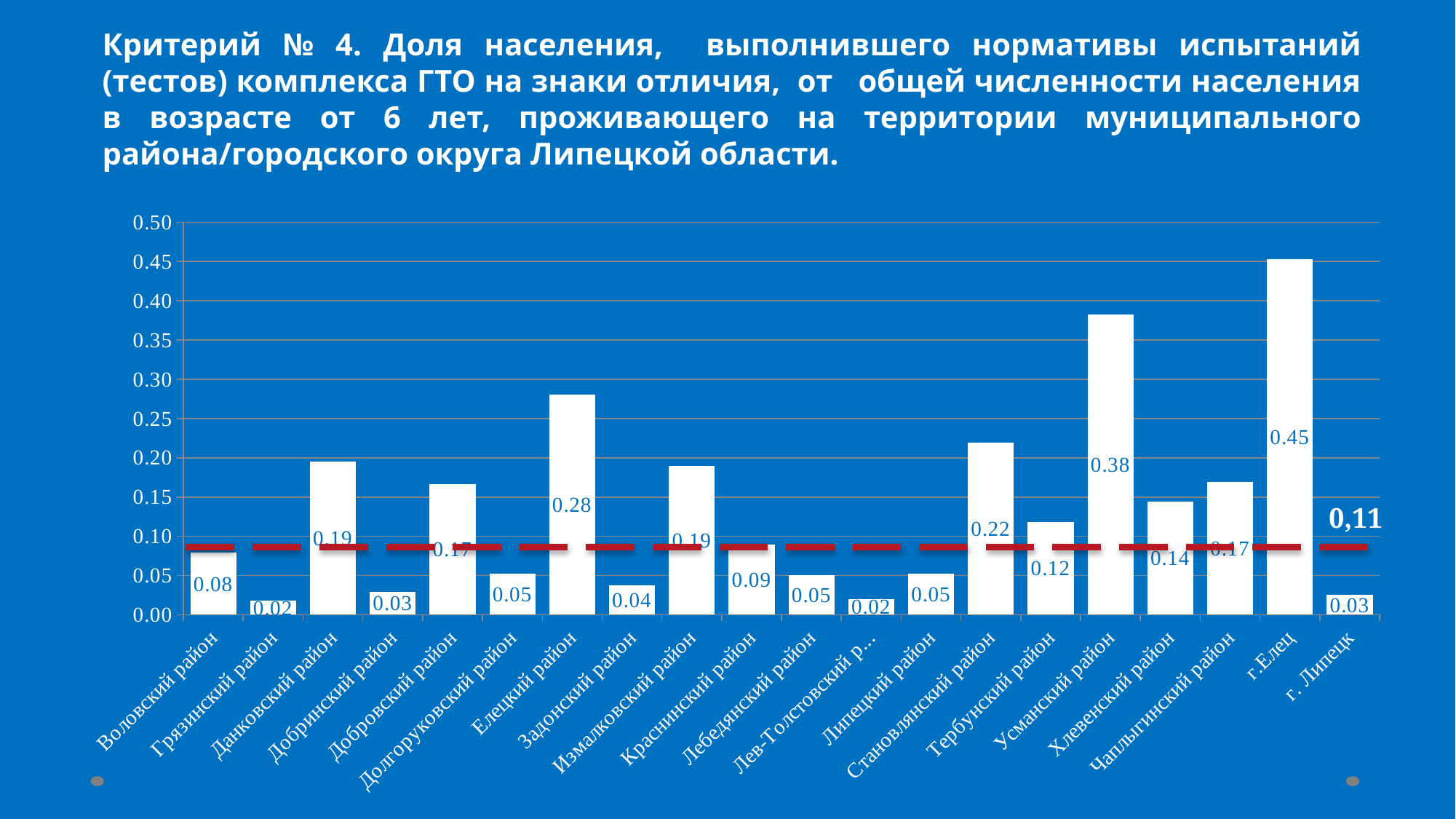
What value is labelled on the red dashed horizontal line? 0,11 What is the difference between the values for г.Елец and Усманский район? 0.07 What is the value for Елецкий район? 0.28 What is the value for г. Липецк? 0.03 How many categories are shown on the x axis? 20 Which category has the highest value? г.Елец What is the value for Тербунский район? 0.12 What kind of chart is shown on the slide? bar chart Which is larger, the value for Усманский район or the value for Елецкий район? Усманский район What is the value for Усманский район? 0.38 What is the value for Становлянский район? 0.22 Is the value for Усманский район greater or less than 0.35? greater